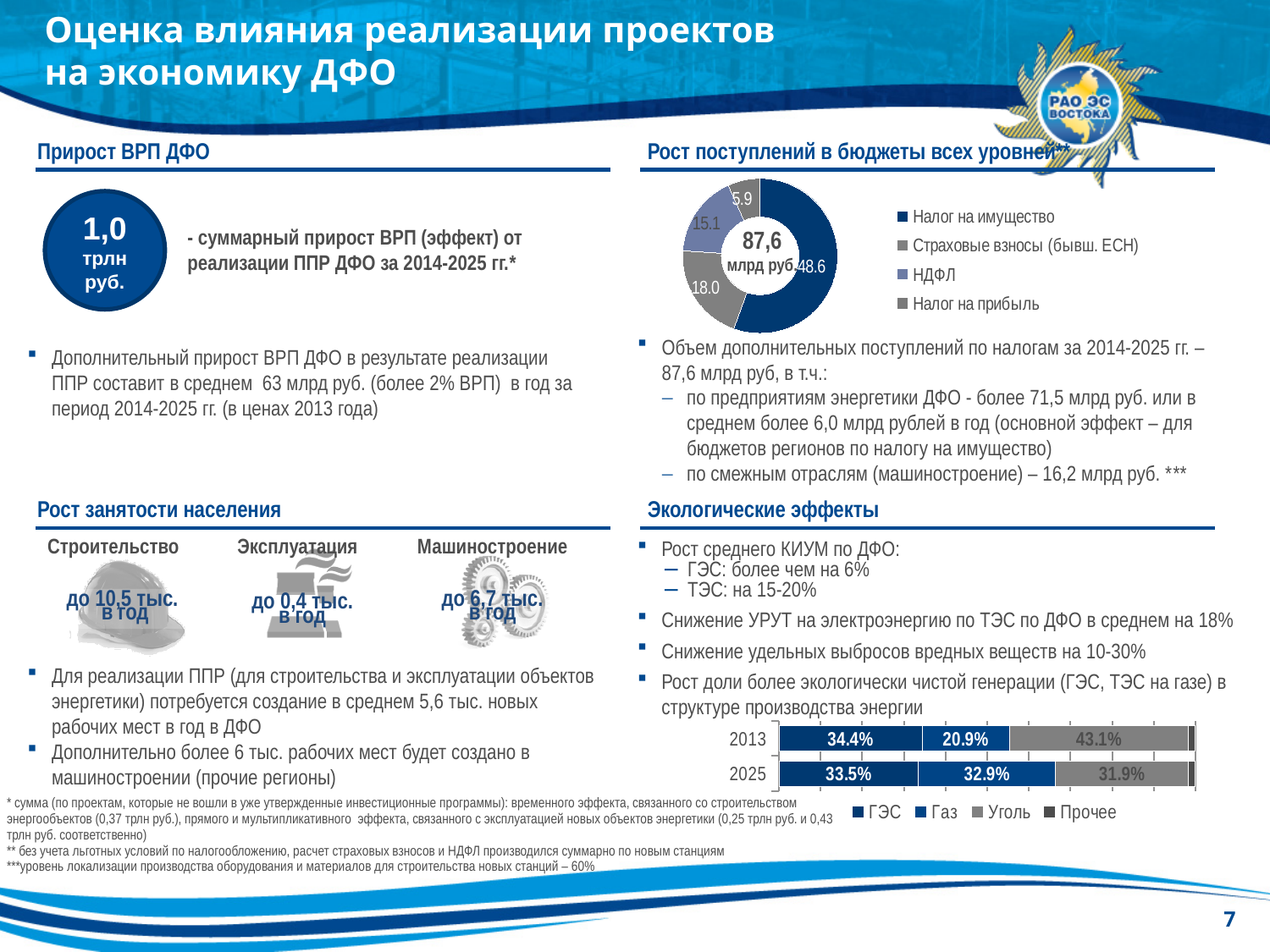
On the doughnut chart 'Рост поступлений в бюджеты всех уровней', what is the value for Налог на имущество? 48.6 On the stacked bar chart at the bottom right (ГЭС, Газ, Уголь, Прочее), what is the difference between the Газ values for 2025 and 2013? 12.0% On the doughnut chart 'Рост поступлений в бюджеты всех уровней', which category has the smallest value? Налог на прибыль How many categories does the legend of the doughnut chart 'Рост поступлений в бюджеты всех уровней' list? 4 On the doughnut chart 'Рост поступлений в бюджеты всех уровней', what is the value for Налог на прибыль? 5.9 On the stacked bar chart at the bottom right (ГЭС, Газ, Уголь, Прочее), what is the value for Газ in 2025? 32.9% On the doughnut chart 'Рост поступлений в бюджеты всех уровней', what is the value for НДФЛ? 15.1 On the doughnut chart 'Рост поступлений в бюджеты всех уровней', which category has the largest value? Налог на имущество On the doughnut chart 'Рост поступлений в бюджеты всех уровней', what total is shown in the centre of the chart? 87,6 млрд руб. On the doughnut chart 'Рост поступлений в бюджеты всех уровней', what is the difference between Страховые взносы (бывш. ЕСН) and НДФЛ? 2.9 On the stacked bar chart at the bottom right (ГЭС, Газ, Уголь, Прочее), what is the value for Уголь in 2013? 43.1% On the stacked bar chart at the bottom right (ГЭС, Газ, Уголь, Прочее), does the share of Уголь rise or fall from 2013 to 2025? fall